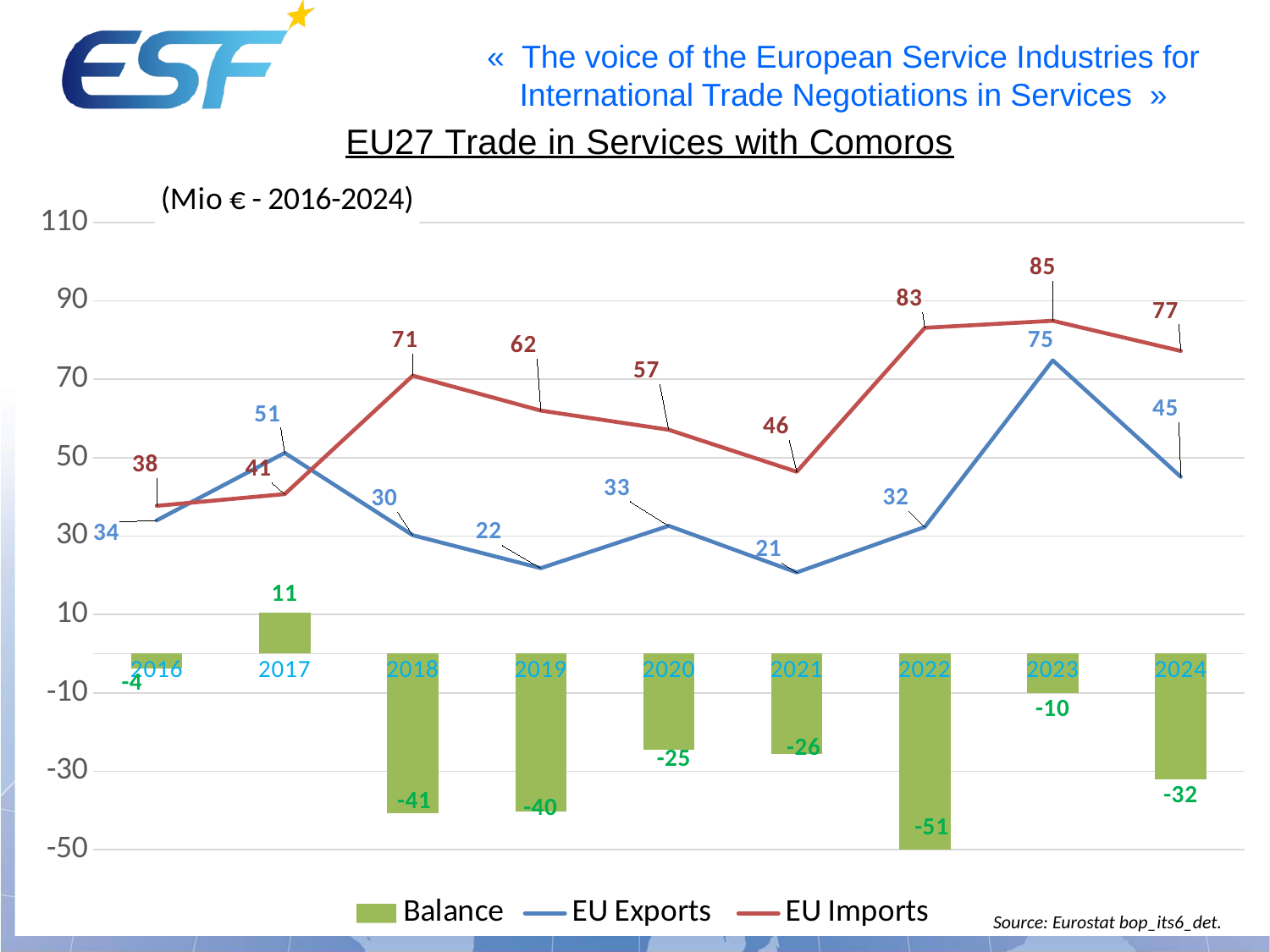
What is the Balance value for 2022? -51 Which year is the only one with a positive Balance? 2017 How many years are shown on the x axis? 9 What is the value of EU Imports in 2018? 71 What is the value of EU Exports in 2023? 75 In which year are EU Imports highest? 2023 What is the difference between EU Imports and EU Exports in 2024? 32 Which is larger in 2017, EU Exports or EU Imports? EU Exports What kind of chart is used for the Balance series? Bar chart Do EU Imports rise or fall from 2018 to 2021? Fall How many series does the legend list? 3 In which year are EU Exports lowest? 2021